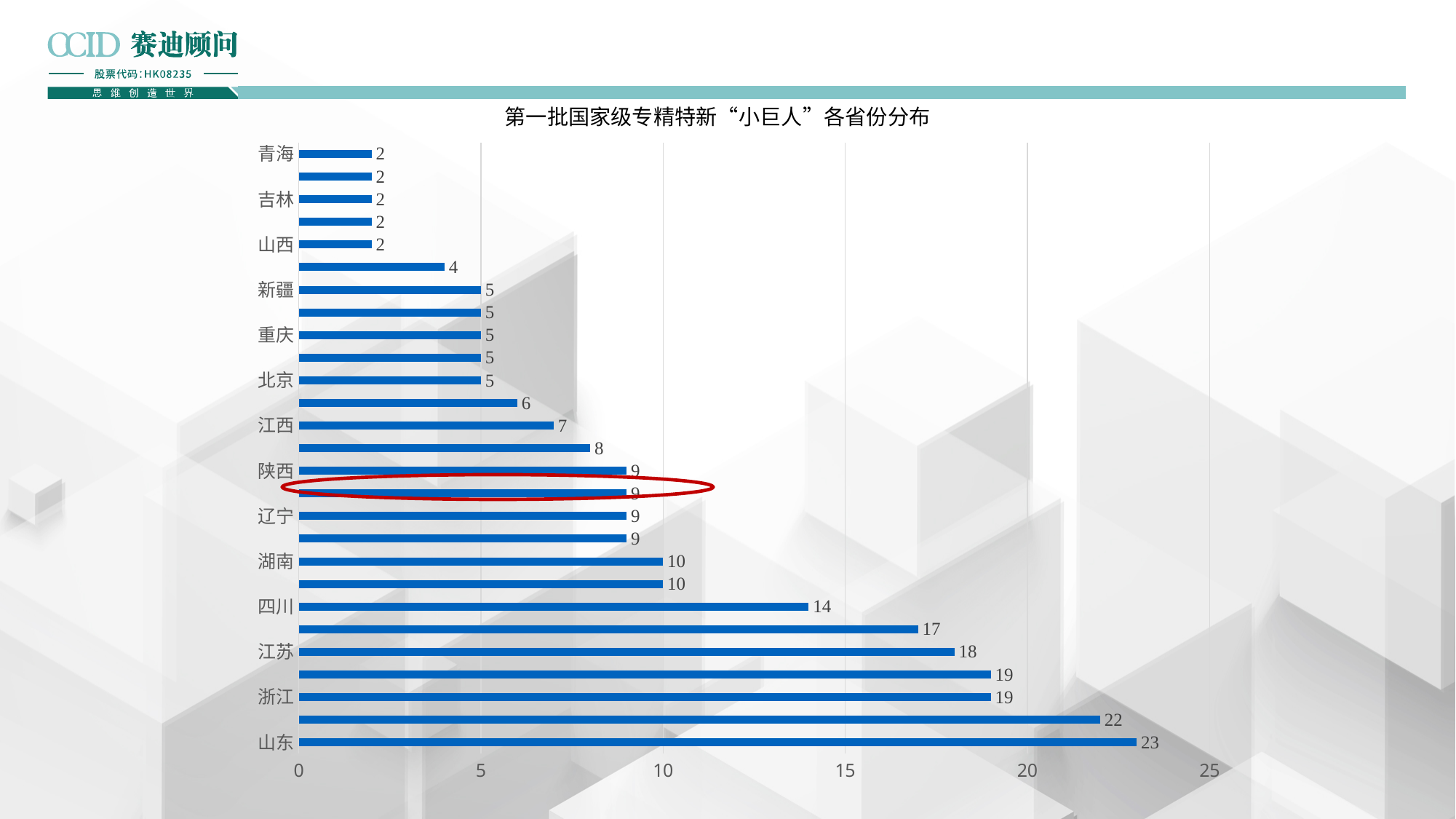
What is the value for 山东? 23 What is the title of the chart? 第一批国家级专精特新“小巨人”各省份分布 Is the value for 山东 greater or less than 20? greater What is the value for 四川? 14 Which province has the highest value? 山东 What kind of chart is shown on the slide? bar chart Which has a larger value, 四川 or 湖南? 四川 What is the difference between the values for 湖南 and 江西? 3 What is the value for 江苏? 18 What is the value for 江西? 7 What is the difference between the values for 山东 and 浙江? 4 What is the value for 北京? 5